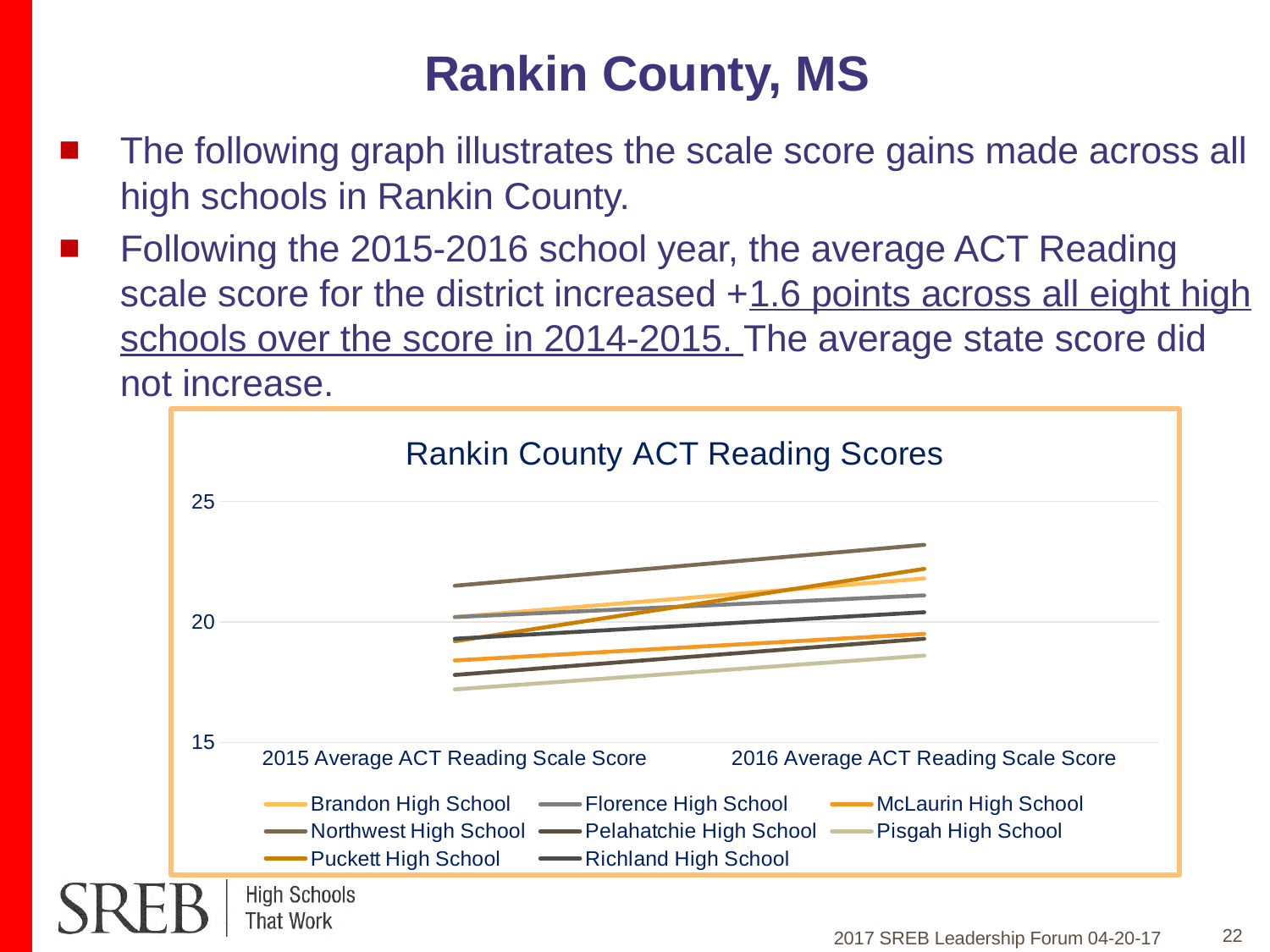
Is the 2015 Average ACT Reading Scale Score for Pisgah High School greater or less than 20? less Which is larger in 2016: the Average ACT Reading Scale Score for Northwest High School or for Pisgah High School? Northwest High School Do the lines for the high schools rise or fall from 2015 to 2016? rise Which high school has the highest 2016 Average ACT Reading Scale Score? Northwest High School Which high school has the lowest 2015 Average ACT Reading Scale Score? Pisgah High School What is the title of the chart? Rankin County ACT Reading Scores How many high schools does the chart's legend list? 8 What kind of chart is shown on the slide? line chart How many points are shown along the x axis of the chart? 2 Which high school has the lowest 2016 Average ACT Reading Scale Score? Pisgah High School Is the 2015 Average ACT Reading Scale Score for Pelahatchie High School greater or less than 20? less Is the 2016 Average ACT Reading Scale Score for Northwest High School greater or less than 20? greater